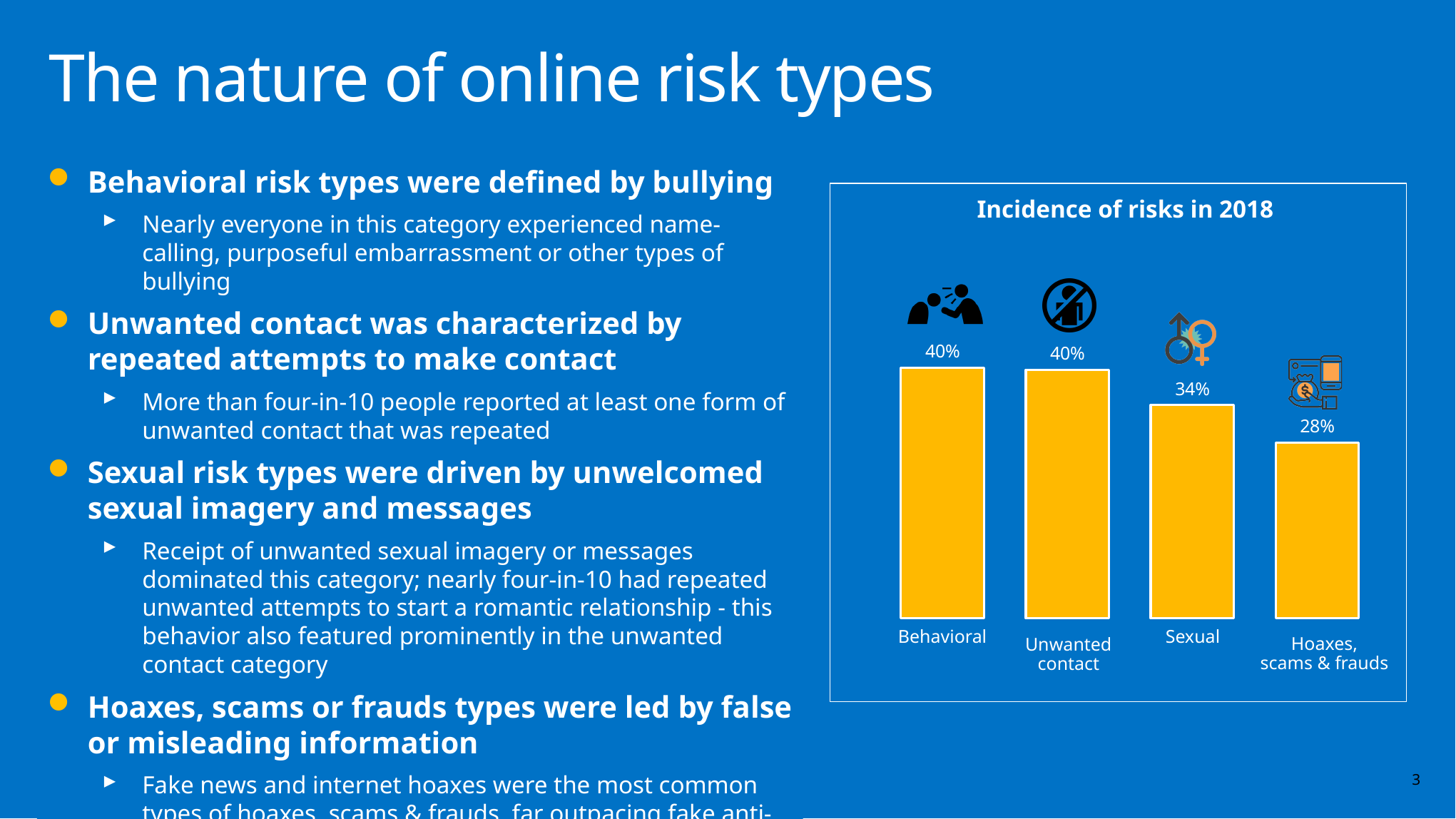
What is the incidence value for Unwanted contact in the chart? 40% What is the incidence value for Hoaxes, scams & frauds in the chart? 28% What kind of chart is shown on the slide? Bar chart Which risk category has the lowest incidence in the chart? Hoaxes, scams & frauds What is the difference between the incidence of Behavioral risks and Sexual risks? 6% What is the difference between the incidence of Sexual risks and Hoaxes, scams & frauds? 6% What is the title of the chart? Incidence of risks in 2018 What is the incidence value for Sexual risks in the chart? 34% What is the incidence value for Behavioral risks in the chart? 40% Do the values in the chart rise or fall from left to right? Fall Which is larger, the incidence of Unwanted contact or of Hoaxes, scams & frauds? Unwanted contact How many risk categories are shown in the chart? 4